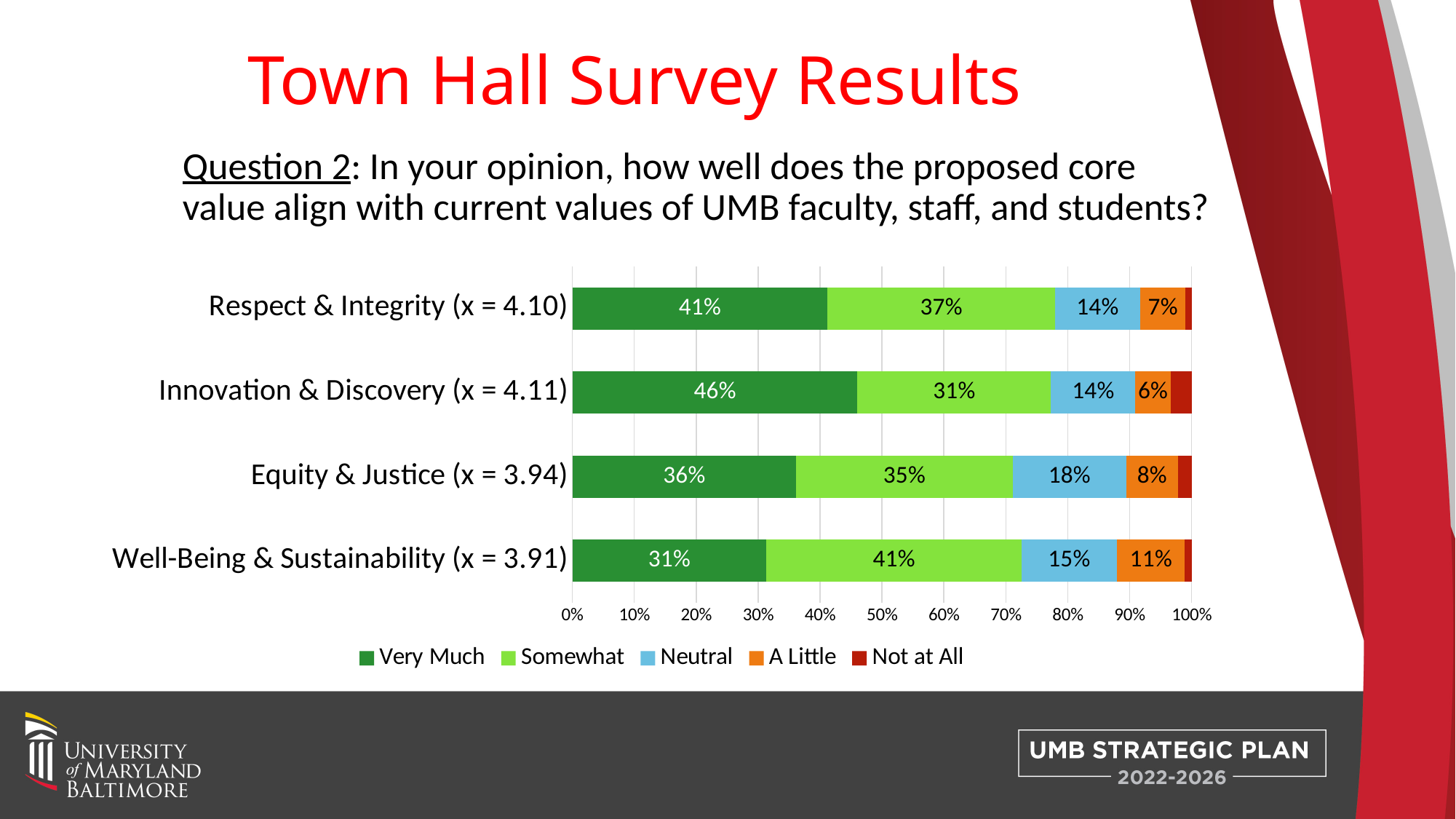
What percentage of respondents answered "Very Much" for Innovation & Discovery? 46% How many core values (categories) are shown in the chart? 4 What is the difference between the "Very Much" percentages for Innovation & Discovery and Well-Being & Sustainability? 15% What is the "A Little" value for Respect & Integrity? 7% What percentage of respondents answered "Somewhat" for Well-Being & Sustainability? 41% Which response option is shown in orange in the legend? A Little Which is larger: the "Somewhat" value for Respect & Integrity or the "Somewhat" value for Innovation & Discovery? Respect & Integrity Which core value has the highest "Very Much" percentage? Innovation & Discovery What kind of chart is shown on the slide? Stacked bar chart What is the "Neutral" value for Equity & Justice? 18% How many response options does the legend list? 5 Which core value has the lowest "Very Much" percentage? Well-Being & Sustainability